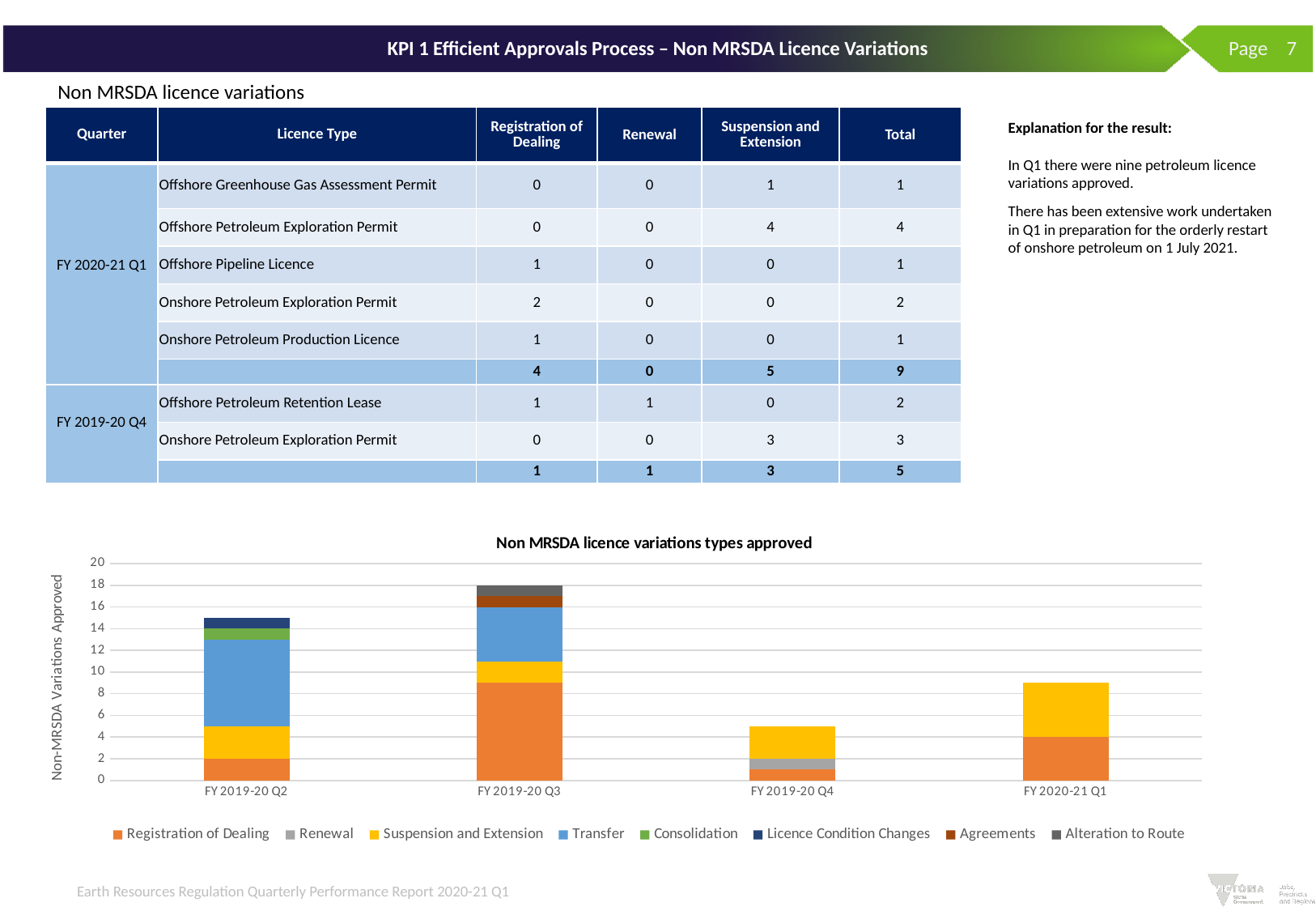
Is the total for FY 2020-21 Q1 greater or less than 10? less What is the total height of the stacked bar for FY 2019-20 Q3? 18 What colour represents Registration of Dealing in the chart? orange What is the title of the chart? Non MRSDA licence variations types approved Which quarter has the highest total of non-MRSDA variations approved in the chart? FY 2019-20 Q3 Which quarter has the lowest total of non-MRSDA variations approved in the chart? FY 2019-20 Q4 Does the total of variations approved rise or fall from FY 2019-20 Q3 to FY 2019-20 Q4? fall Which quarter has a taller stacked bar, FY 2019-20 Q2 or FY 2020-21 Q1? FY 2019-20 Q2 How many series does the legend of the chart list? 8 Is the total for FY 2019-20 Q2 greater or less than 14? greater What kind of chart is shown on the slide? bar chart How many quarters are plotted on the x axis of the chart? 4